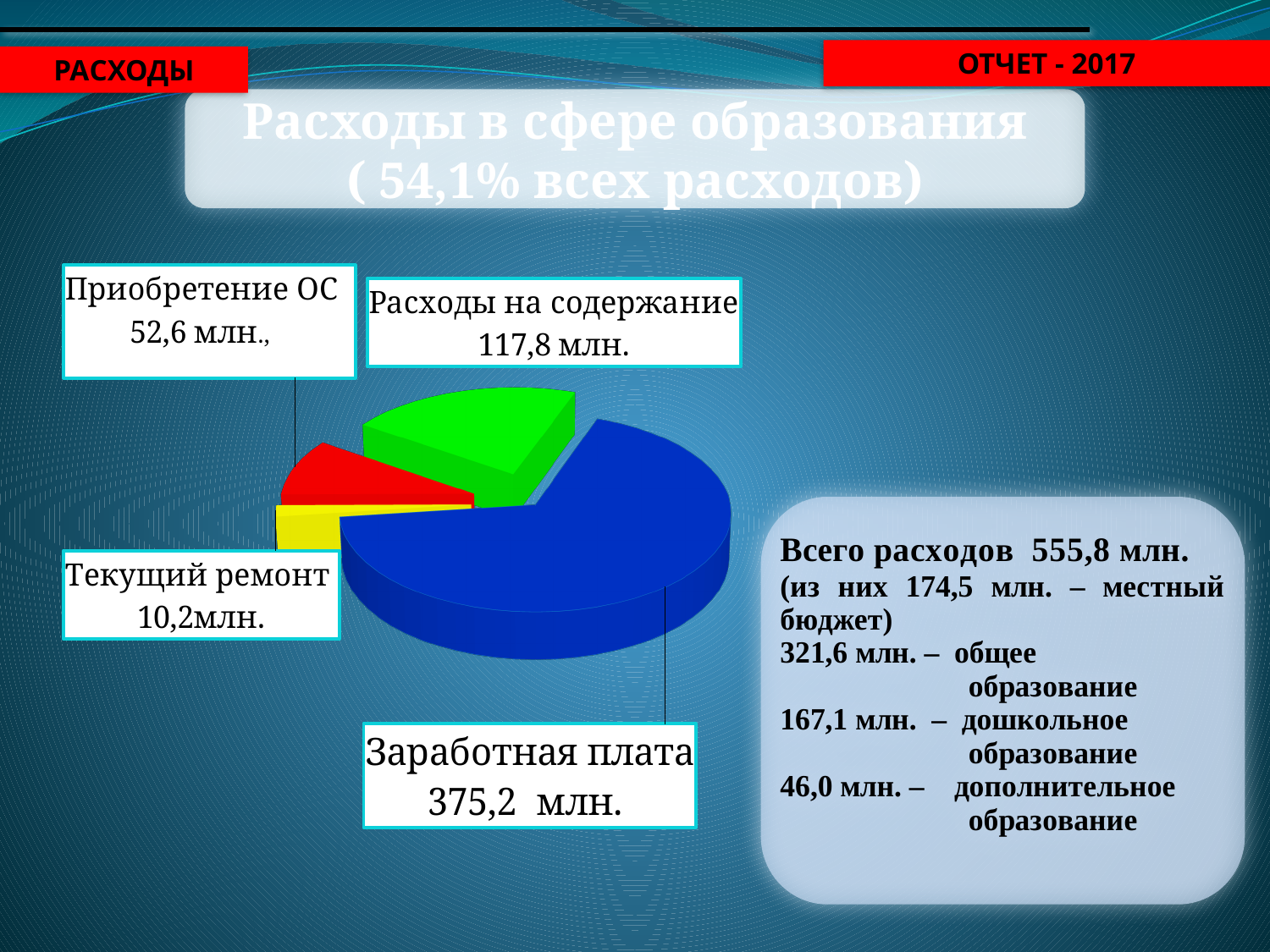
What is the value for Текущий ремонт? 10,2 млн. Which category has the smallest slice of the pie? Текущий ремонт How many slices does the pie chart have? 4 What is the total of all four slices of the pie chart? 555,8 млн. Which is larger, Расходы на содержание or Приобретение ОС? Расходы на содержание What kind of chart is shown on the slide? pie chart What is the difference between Заработная плата and Расходы на содержание? 257,4 млн. What is the value for Заработная плата? 375,2 млн. What colour is the slice for Заработная плата? blue What is the value for Расходы на содержание? 117,8 млн. What is the value for Приобретение ОС? 52,6 млн. Which category has the largest slice of the pie? Заработная плата